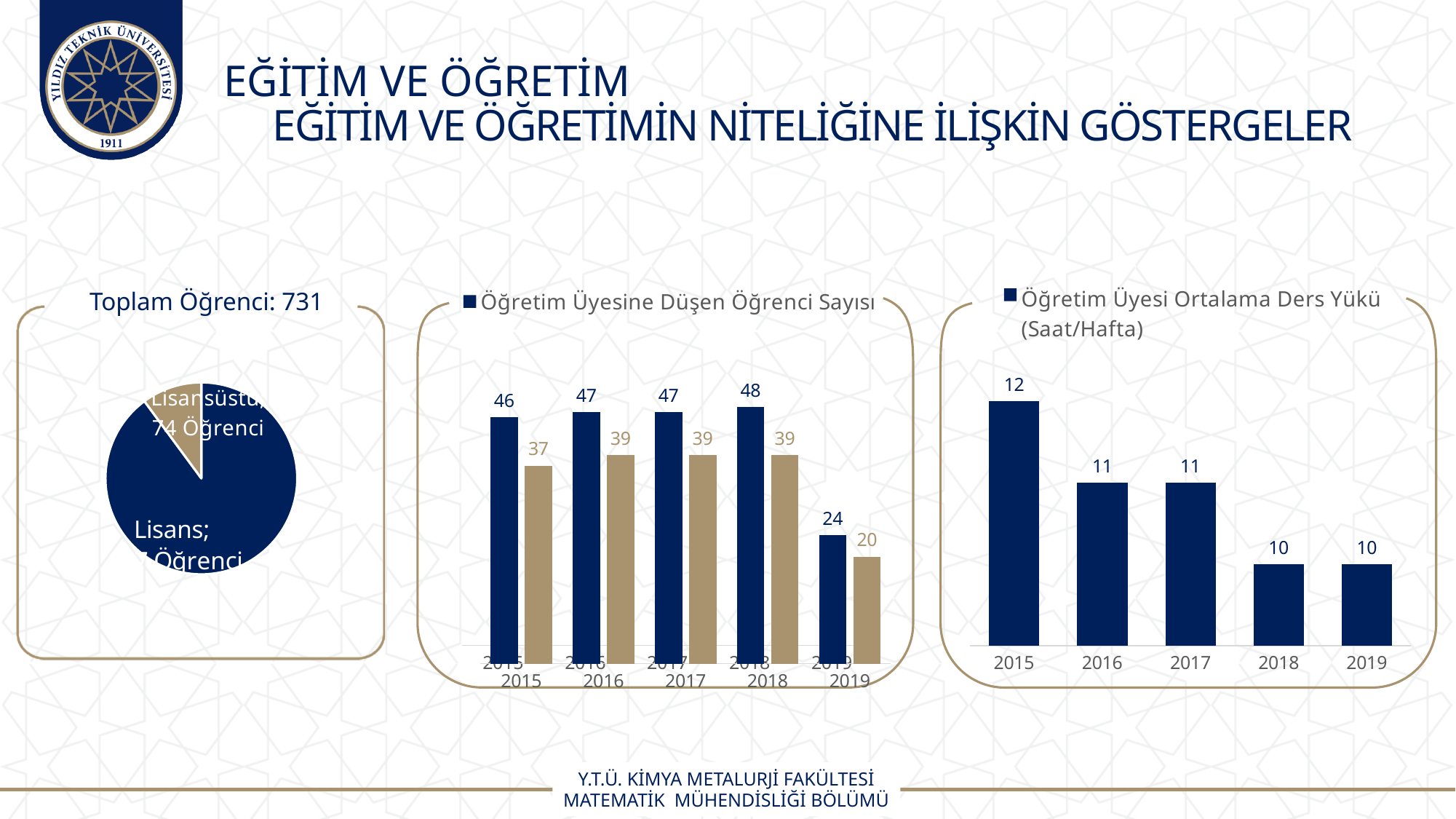
In the chart titled 'Öğretim Üyesi Ortalama Ders Yükü (Saat/Hafta)', which year has the highest value? 2015 In the chart titled 'Öğretim Üyesi Ortalama Ders Yükü (Saat/Hafta)', do the values rise or fall from 2015 to 2019? fall In the chart titled 'Öğretim Üyesine Düşen Öğrenci Sayısı', what is the value of the dark blue bar for 2018? 48 In the chart titled 'Öğretim Üyesi Ortalama Ders Yükü (Saat/Hafta)', how many years are shown on the x axis? 5 In the chart titled 'Öğretim Üyesi Ortalama Ders Yükü (Saat/Hafta)', what is the value for 2015? 12 What kind of chart is shown under 'Toplam Öğrenci: 731'? pie chart In the pie chart under 'Toplam Öğrenci: 731', what is the value shown for Lisansüstü? 74 Öğrenci In the chart titled 'Öğretim Üyesine Düşen Öğrenci Sayısı', what is the difference between the dark blue bar and the tan bar for 2018? 9 In the chart titled 'Öğretim Üyesi Ortalama Ders Yükü (Saat/Hafta)', what is the difference between the values for 2015 and 2018? 2 In the chart titled 'Öğretim Üyesi Ortalama Ders Yükü (Saat/Hafta)', what is the value for 2019? 10 In the chart titled 'Öğretim Üyesine Düşen Öğrenci Sayısı', which year has the lowest dark blue bar? 2019 In the chart titled 'Öğretim Üyesine Düşen Öğrenci Sayısı', what is the value of the tan bar for 2019? 20